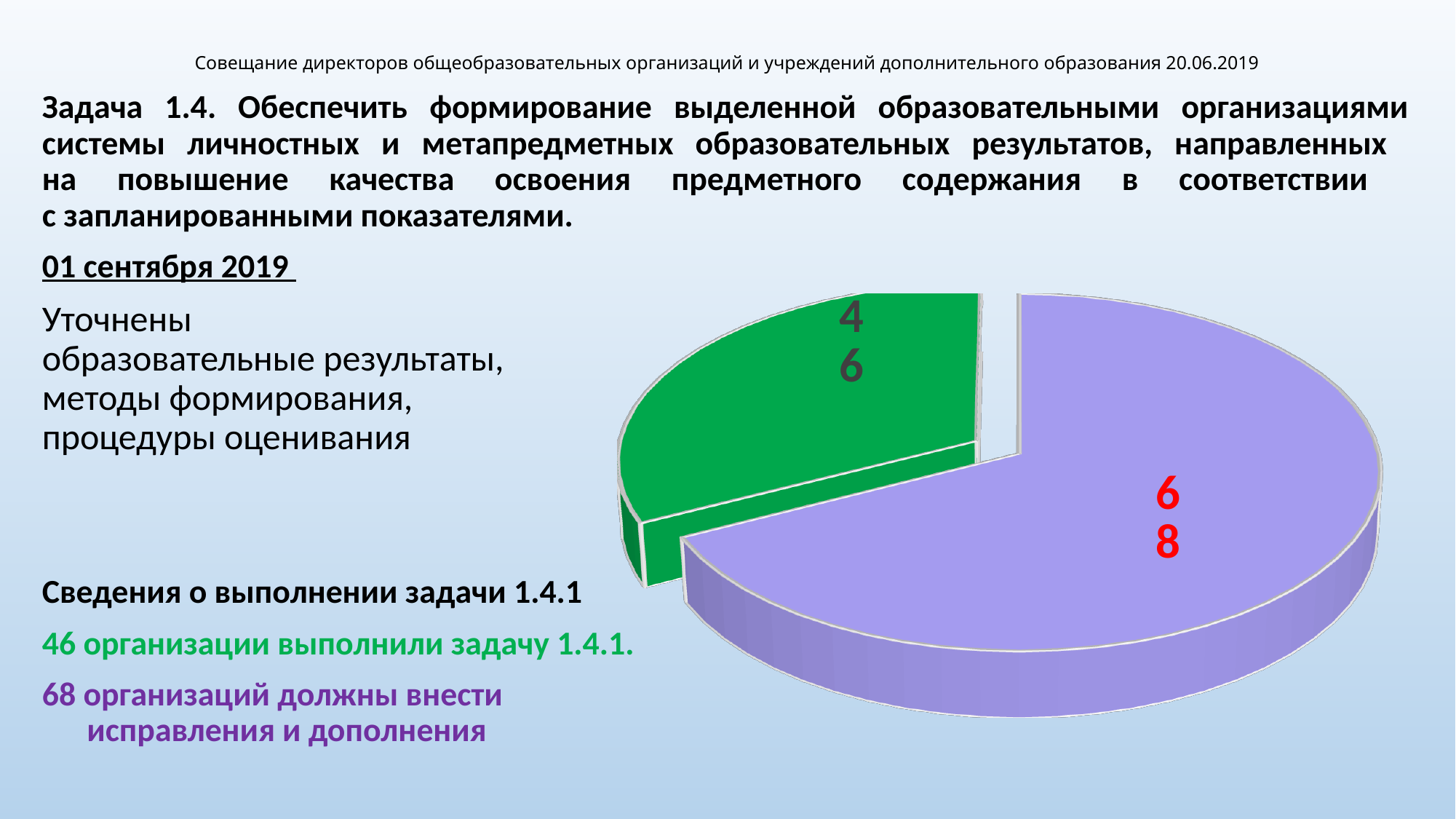
What kind of chart is shown on the slide? Pie chart How many slices does the pie chart have? 2 Which slice of the pie chart is the smallest? The green slice (46) Which slice of the pie chart is the largest? The purple slice (68) According to the slide text, how many organizations completed task 1.4.1 (the green slice)? 46 What colour is the slice representing the 68 organizations that must make corrections and additions? Purple What is the total of the two slice values in the pie chart? 114 What value is printed on the purple slice of the pie chart? 68 What value is printed on the green slice of the pie chart? 46 What is the difference between the purple slice value and the green slice value in the pie chart? 22 Which is larger in the pie chart: the green slice or the purple slice? The purple slice